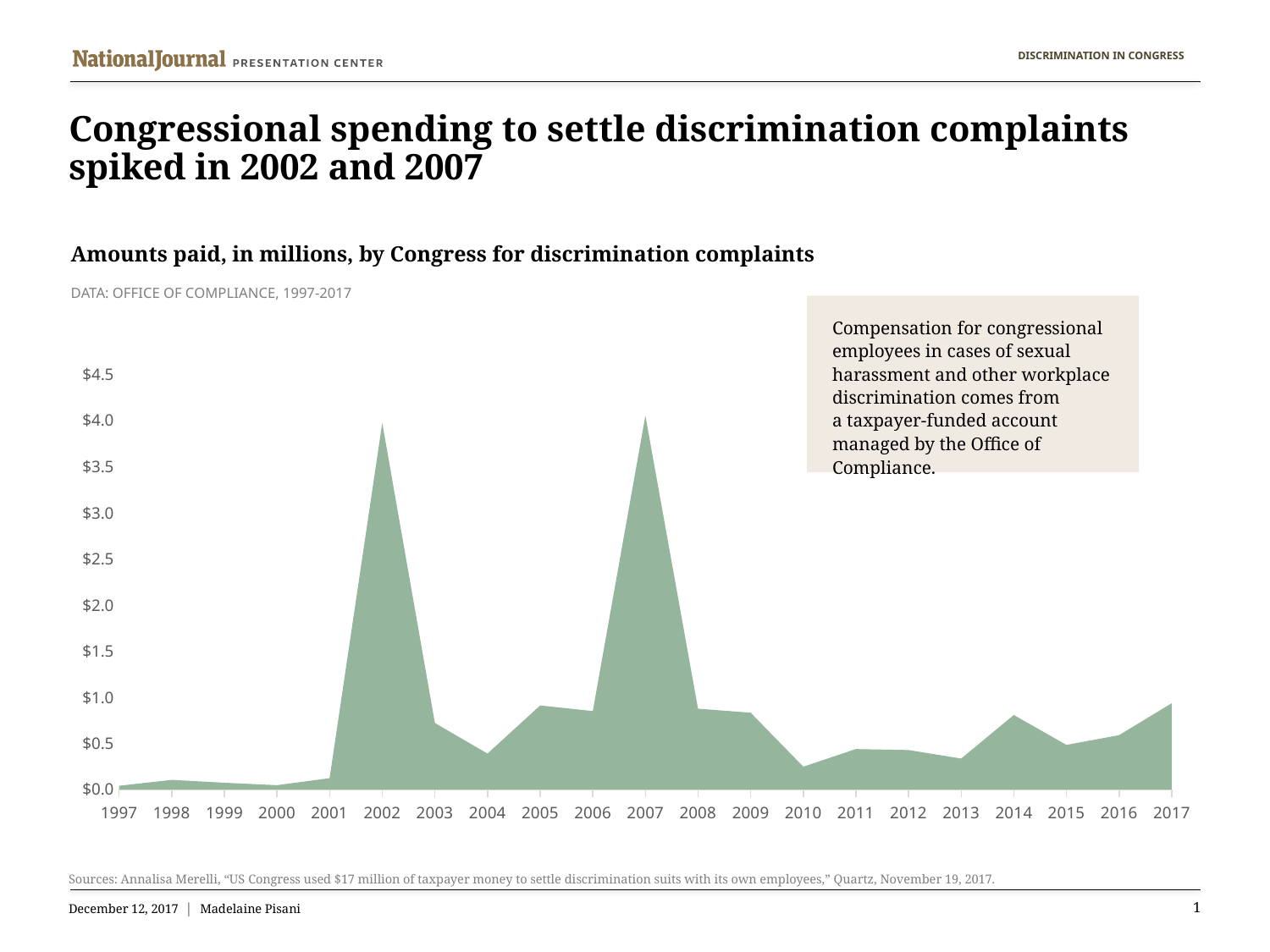
Which year has the larger value, 2002 or 2003? 2002 Which year has the larger value, 2010 or 2014? 2014 Is the value for 2003 greater or less than $1.0? less Do the values rise or fall from 2015 to 2017? rise Is the value for 2010 greater or less than $0.5? less How many years are plotted along the x axis? 21 What kind of chart is shown on the slide? Area chart Is the value for 2001 greater or less than $0.5? less What is the title of the chart? Amounts paid, in millions, by Congress for discrimination complaints